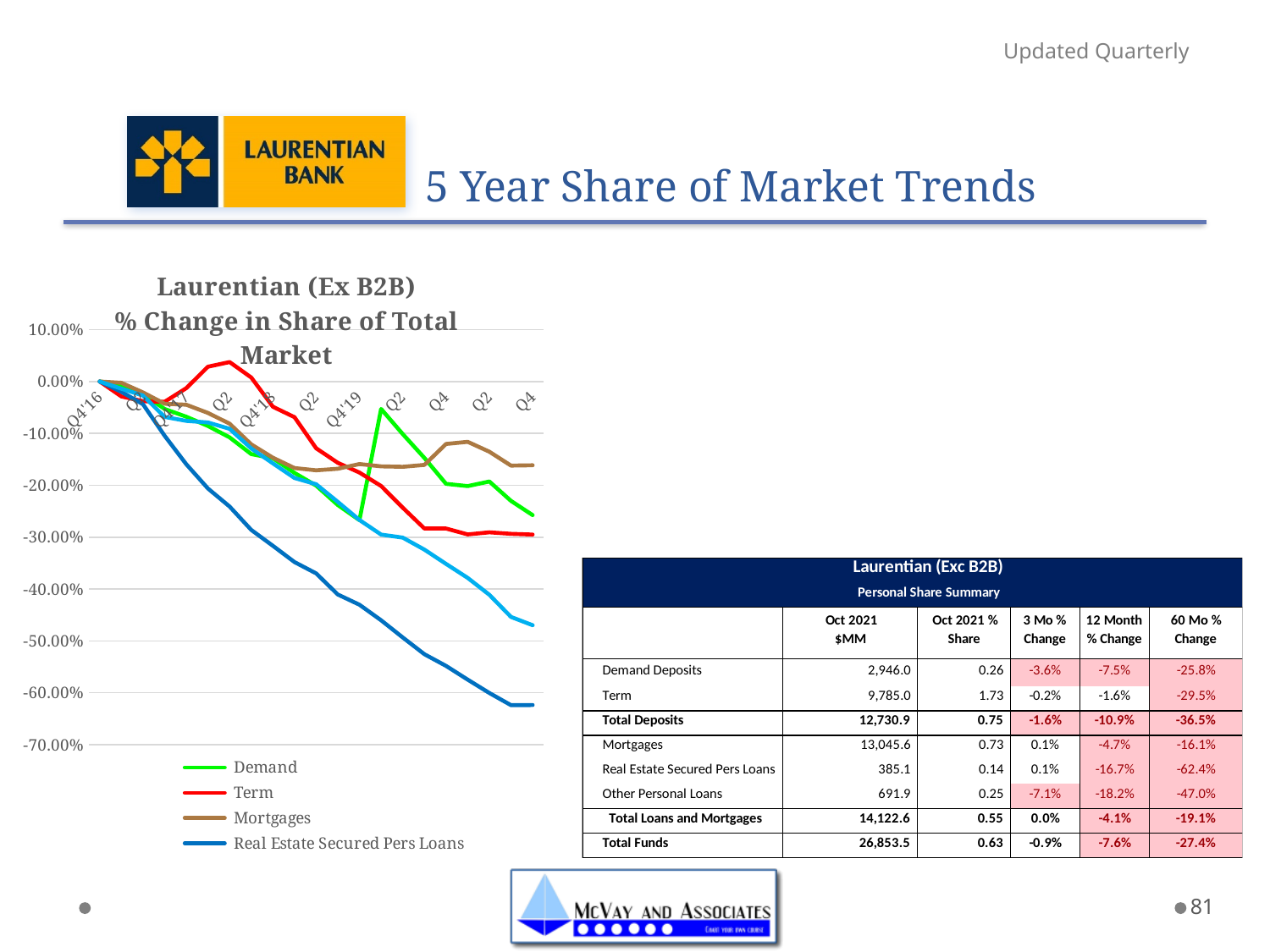
How many series does the chart's legend list? 4 At the right end of the chart, which is higher: Demand or Real Estate Secured Pers Loans? Demand Is the final value for Mortgages greater or less than -20.00%? greater Is the final value for Real Estate Secured Pers Loans greater or less than -60.00%? less Does the Real Estate Secured Pers Loans line rise or fall along the x axis? fall Which series has the highest value at the right end of the chart? Mortgages Which series rises above 0.00% at any point on the chart? Term Is the final value for Term greater or less than -20.00%? less At the right end of the chart, which is higher: Mortgages or Term? Mortgages What is the title of the chart? Laurentian (Ex B2B) % Change in Share of Total Market What type of chart is shown on the slide? line chart Which series has the lowest value at the right end of the chart? Real Estate Secured Pers Loans